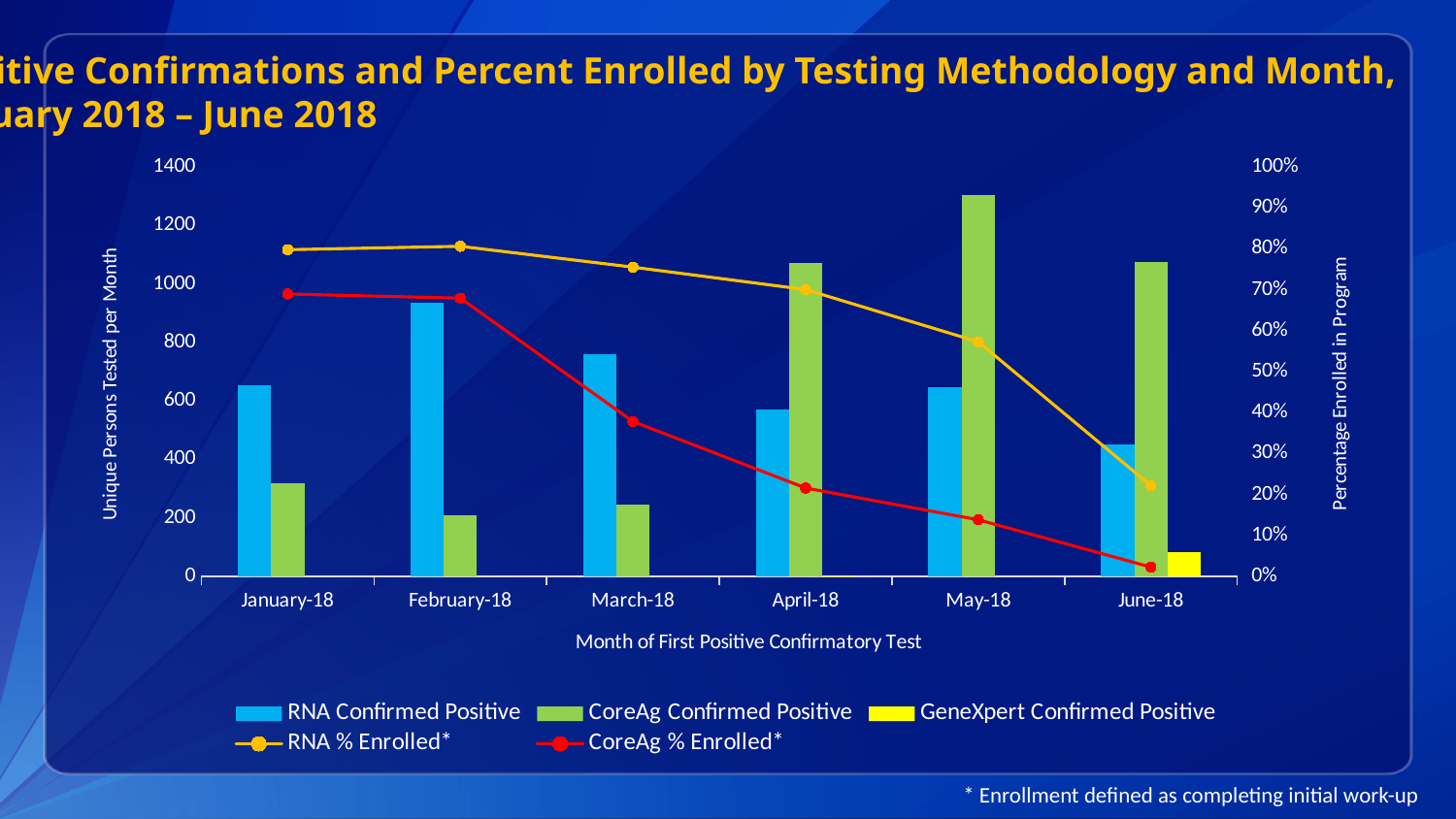
In April-18, which is larger: the RNA Confirmed Positive bar or the CoreAg Confirmed Positive bar? CoreAg Confirmed Positive In which month is the CoreAg Confirmed Positive bar highest? May-18 Does the CoreAg % Enrolled line rise or fall from January-18 to June-18? It falls In which month is the RNA Confirmed Positive bar highest? February-18 How many months are shown on the x axis of the chart? 6 Is the RNA % Enrolled value for June-18 greater or less than 30%? less What kind of chart is shown on the slide? A combination bar and line chart How many series does the chart legend list? 5 Is the RNA Confirmed Positive value for February-18 greater or less than 800? greater In which month does a GeneXpert Confirmed Positive bar appear? June-18 Is the CoreAg Confirmed Positive value for February-18 greater or less than 400? less In which month is the RNA Confirmed Positive bar lowest? June-18